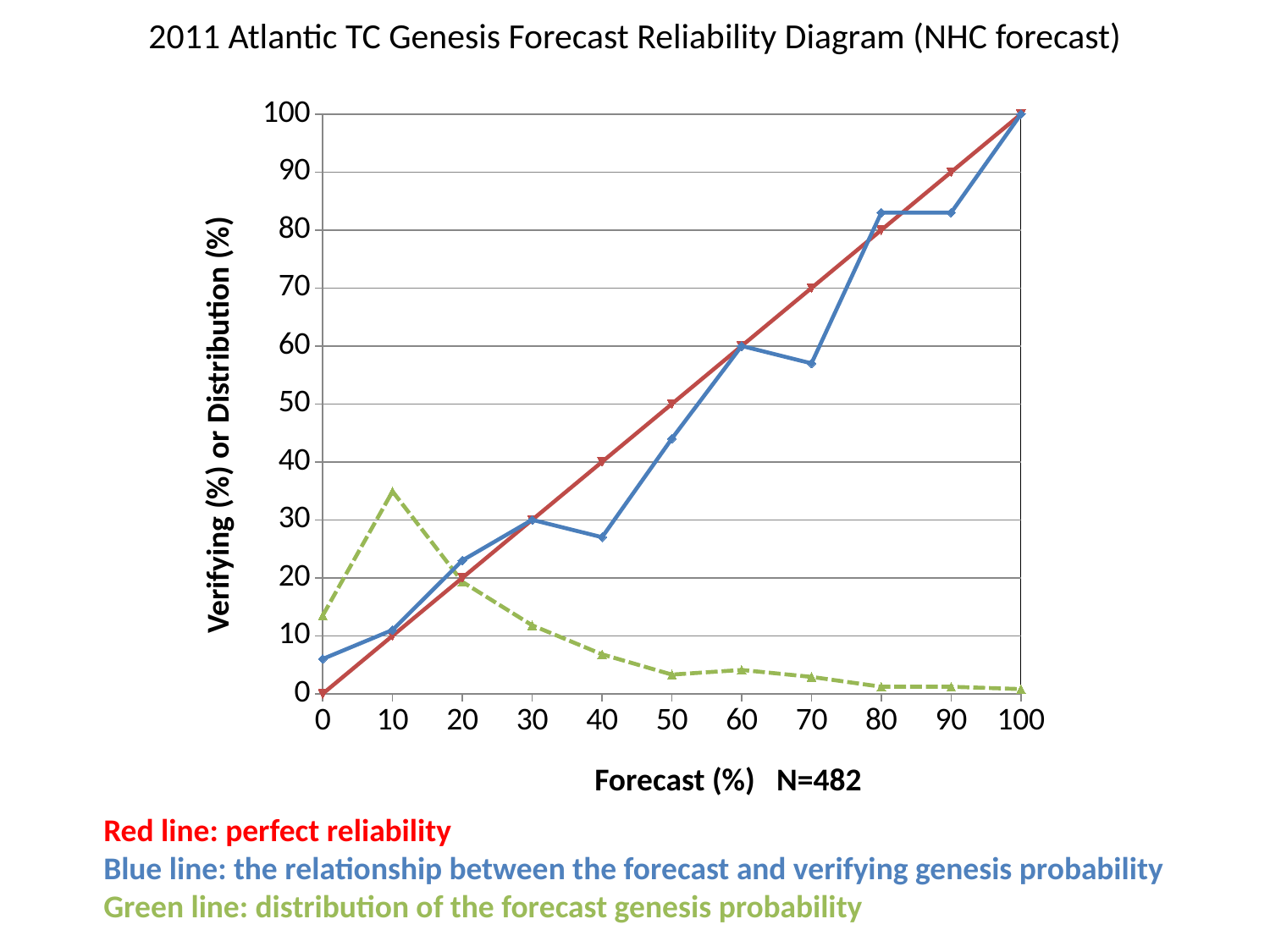
At a forecast of 40%, which line has the higher value, the red line or the blue line? red line At which forecast value does the green line reach its highest point? 10 Does the green line rise or fall as the forecast increases from 10% to 100%? fall What kind of chart is shown on the slide? line chart Is the value of the blue line at a forecast of 70% greater or less than 60? less What is the value of the blue line at a forecast of 30%? 30 Is the value of the green line at a forecast of 50% greater or less than 10? less Is the value of the green line at a forecast of 10% greater or less than 30? greater How many forecast values are marked along the x axis? 11 What is the value of the red line at a forecast of 50%? 50 How many lines are plotted on the chart? 3 What sample size N is given in the x-axis label? N=482